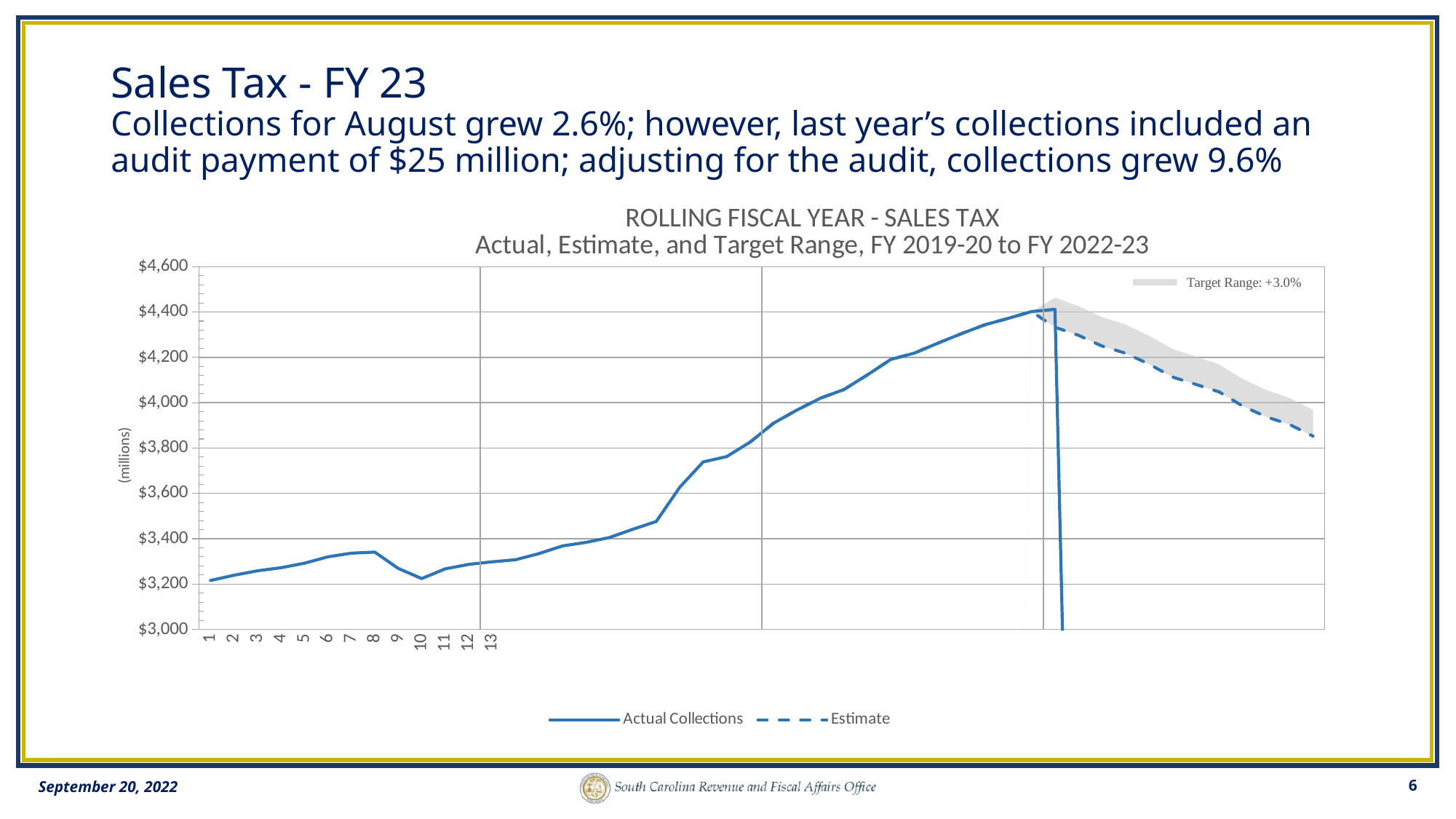
Is the Actual Collections value at point 1 greater or less than $3,400? less What kind of chart is shown on the slide? line chart Is the Actual Collections value at point 10 greater or less than $3,400? less Does the Actual Collections line rise or fall between point 8 and point 10? fall Is the Actual Collections value at point 1 greater or less than $3,000? greater How many series does the chart legend list? 2 What percentage does the legend give for the Target Range? +3.0% Does the Estimate (dashed) line rise or fall as it moves to the right? fall What unit label is shown on the vertical axis of the chart? (millions) Does the Actual Collections line rise or fall between point 1 and point 8? rise